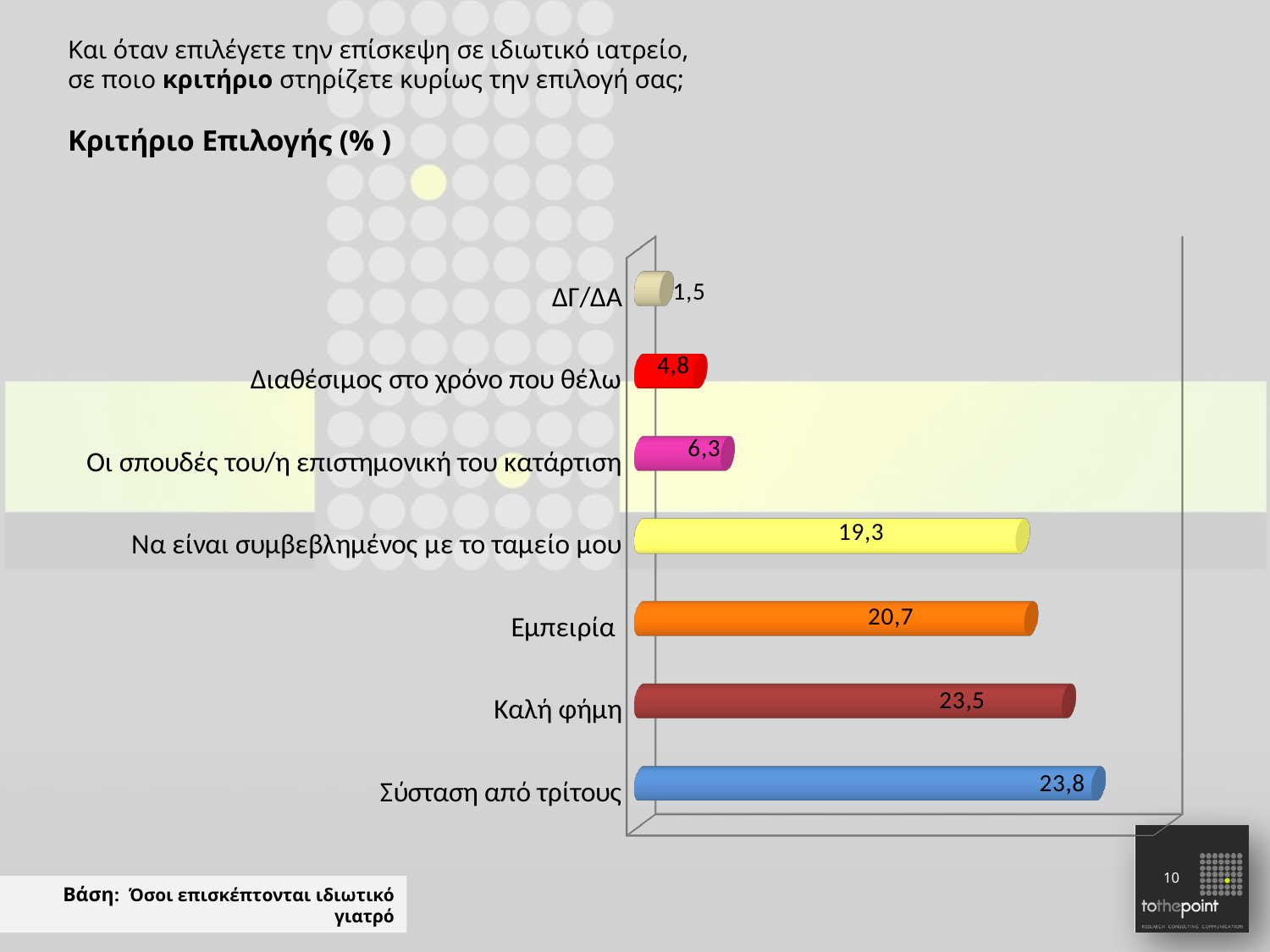
What is the value for Να είναι συμβεβλημένος με το ταμείο μου? 19,3 What is the difference between the values for Σύσταση από τρίτους and Καλή φήμη? 0,3 Which category has the highest value? Σύσταση από τρίτους Which is larger, the value for Καλή φήμη or the value for Εμπειρία? Καλή φήμη What is the value for Εμπειρία? 20,7 What is the title of the chart? Κριτήριο Επιλογής (% ) What is the value for Διαθέσιμος στο χρόνο που θέλω? 4,8 What kind of chart is shown on the slide? Bar chart What is the value for Οι σπουδές του/η επιστημονική του κατάρτιση? 6,3 Which category has the lowest value? ΔΓ/ΔΑ How many categories are shown in the chart? 7 What is the difference between the values for Εμπειρία and Να είναι συμβεβλημένος με το ταμείο μου? 1,4